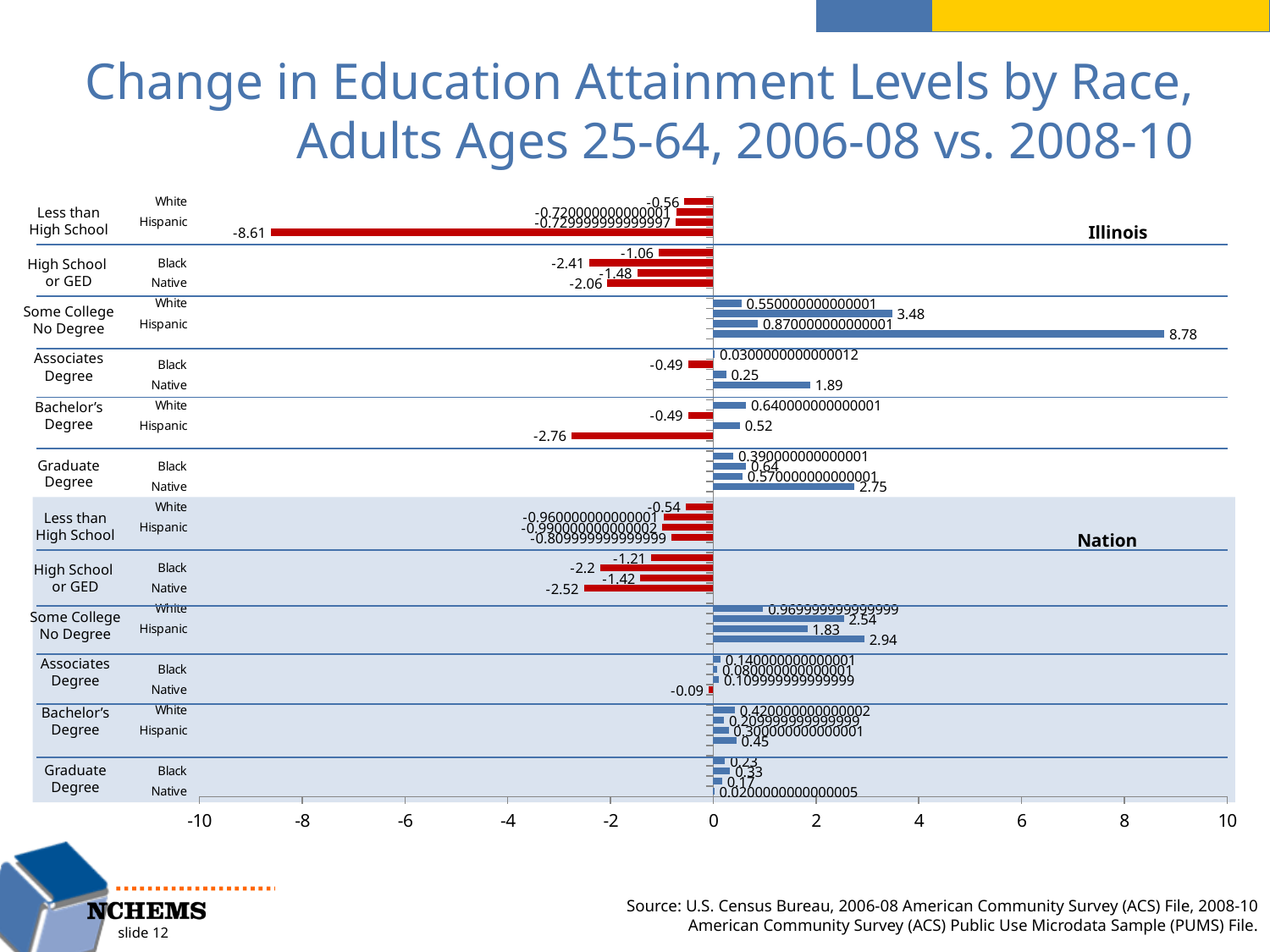
What is the largest value shown anywhere on the chart? 8.78 Which is larger: the High School or GED value for Black adults in Illinois or for Black adults in the Nation? Nation (-2.2) What is the smallest value shown anywhere on the chart? -8.61 In the Nation section, what is the value for Hispanic adults with Some College No Degree? 1.83 In the Illinois section, what is the value for Native adults with an Associates Degree? 1.89 In the Illinois section, what is the difference between the High School or GED values for Black (-2.41) and Native (-2.06) adults? 0.35 What are the minimum and maximum values shown on the x axis? -10 and 10 How many education levels are listed in each of the Illinois and Nation sections? 6 In the Illinois section, what is the value for White adults with Less than High School? -0.56 In the Illinois section, what is the value for Black adults with High School or GED? -2.41 What type of chart is shown on the slide? bar chart In the Nation section, what is the value for Native adults with High School or GED? -2.52